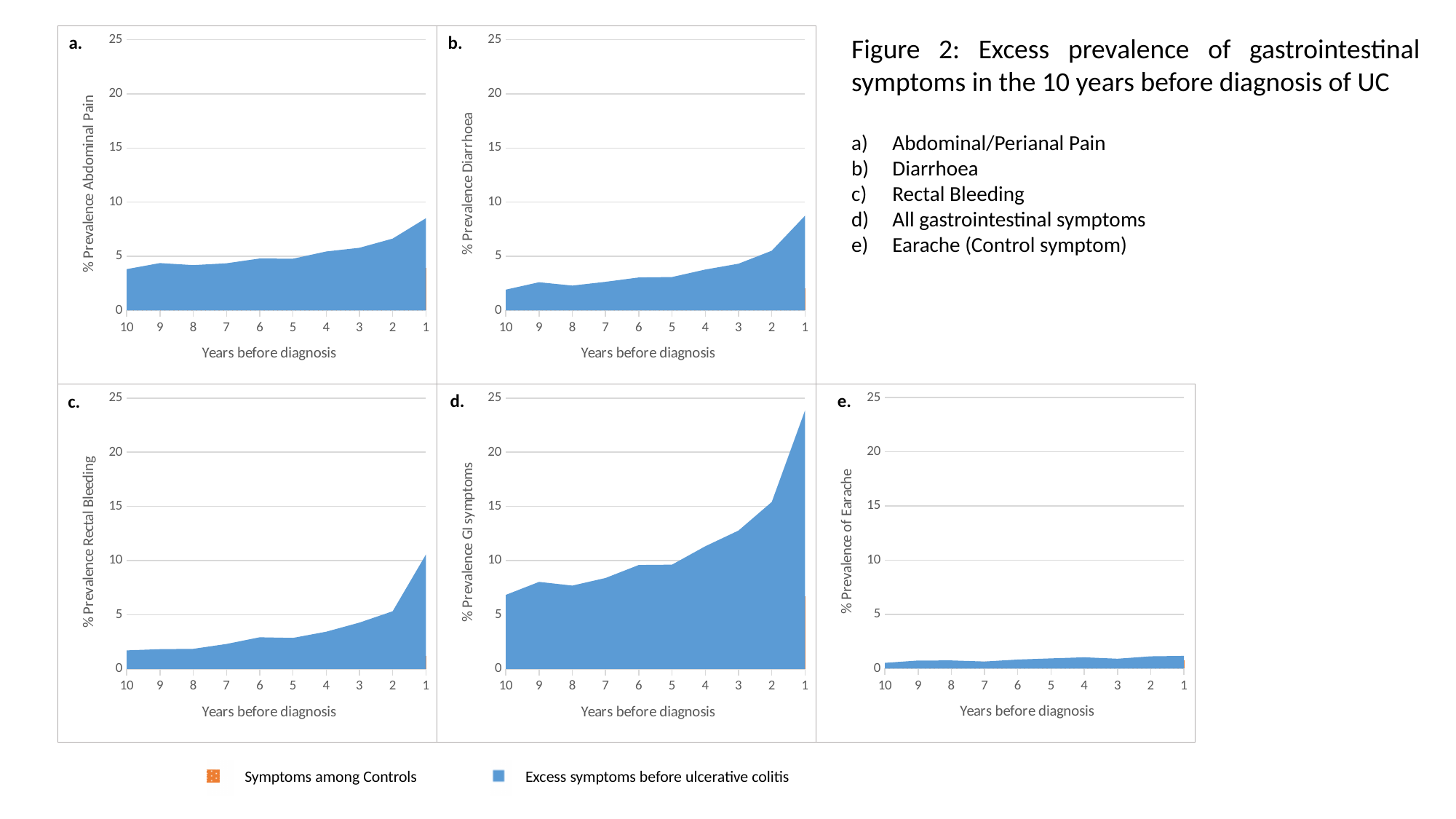
In chart e (Earache), is the value at 1 year before diagnosis greater or less than 5? less In chart c (Rectal Bleeding), is the value at 1 year before diagnosis greater or less than 5? greater How many series does the legend at the bottom of the slide list? 2 Which of the five charts reaches the highest prevalence value at 1 year before diagnosis? Chart d (GI symptoms) In chart d (GI symptoms), is the value at 1 year before diagnosis greater or less than 20? greater What is the y-axis label of chart c? % Prevalence Rectal Bleeding Which legend entry is shown in blue? Excess symptoms before ulcerative colitis How many points along the x axis (years before diagnosis) does chart d (GI symptoms) show? 10 What kind of chart is chart a (Abdominal Pain)? Area chart In chart d (GI symptoms), do the values rise or fall moving from 10 years before diagnosis to 1 year before diagnosis? Rise